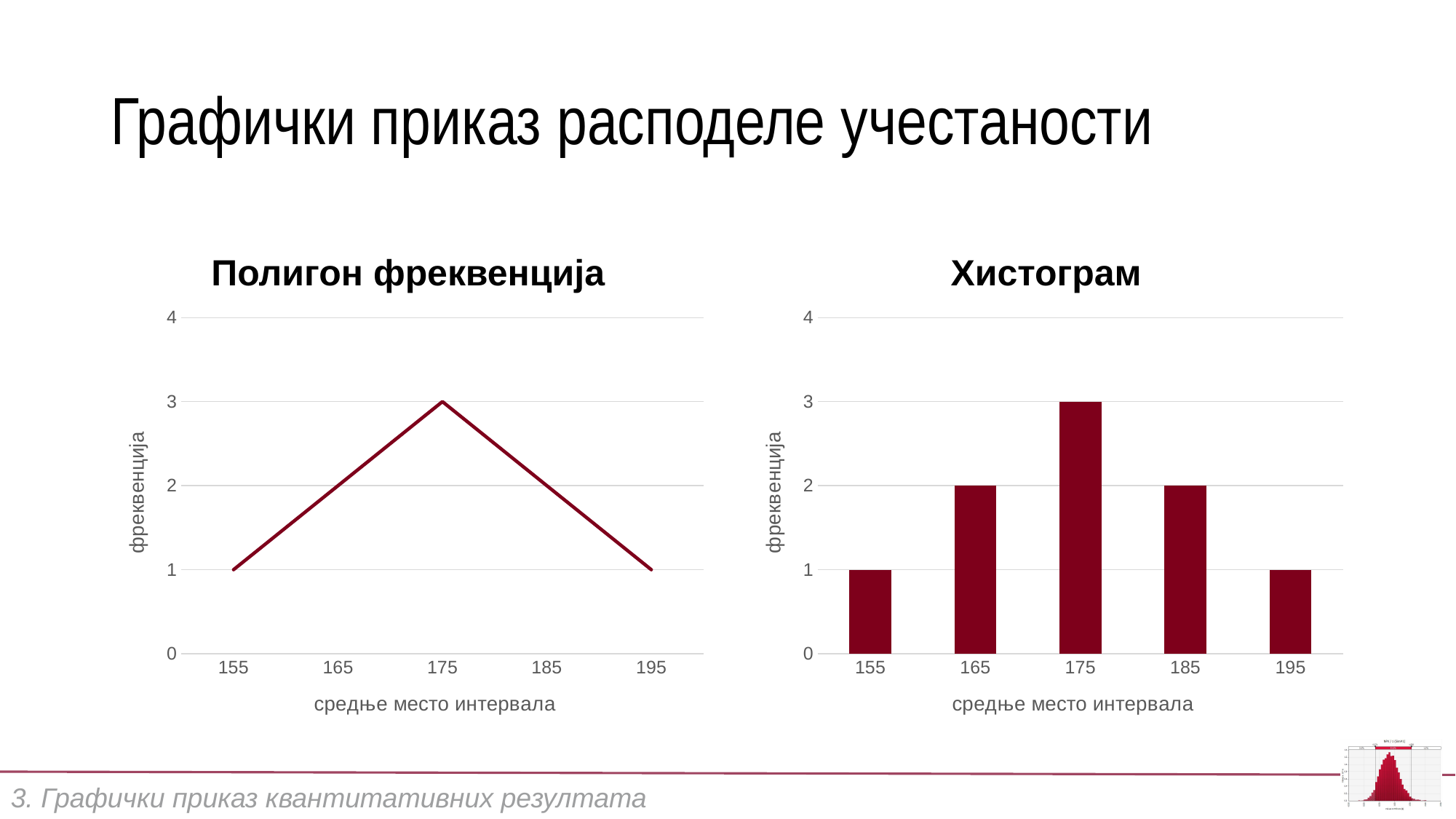
In the chart titled "Полигон фреквенција", do the values rise or fall from 155 to 175? rise What kind of chart is the chart titled "Полигон фреквенција"? line chart What kind of chart is the chart titled "Хистограм"? bar chart In the chart titled "Хистограм", what is the total of all five frequencies? 9 In the chart titled "Хистограм", which is larger: the frequency for 165 or the frequency for 155? 165 How many categories are shown on the x axis of the chart titled "Хистограм"? 5 In the chart titled "Полигон фреквенција", what is the difference between the frequency at 175 and the frequency at 195? 2 In the chart titled "Полигон фреквенција", what is the frequency at 155? 1 What is the x-axis label of the chart titled "Хистограм"? средње место интервала In the chart titled "Хистограм", what is the frequency for 185? 2 In the chart titled "Хистограм", which category has the highest frequency? 175 In the chart titled "Хистограм", what is the frequency for 175? 3